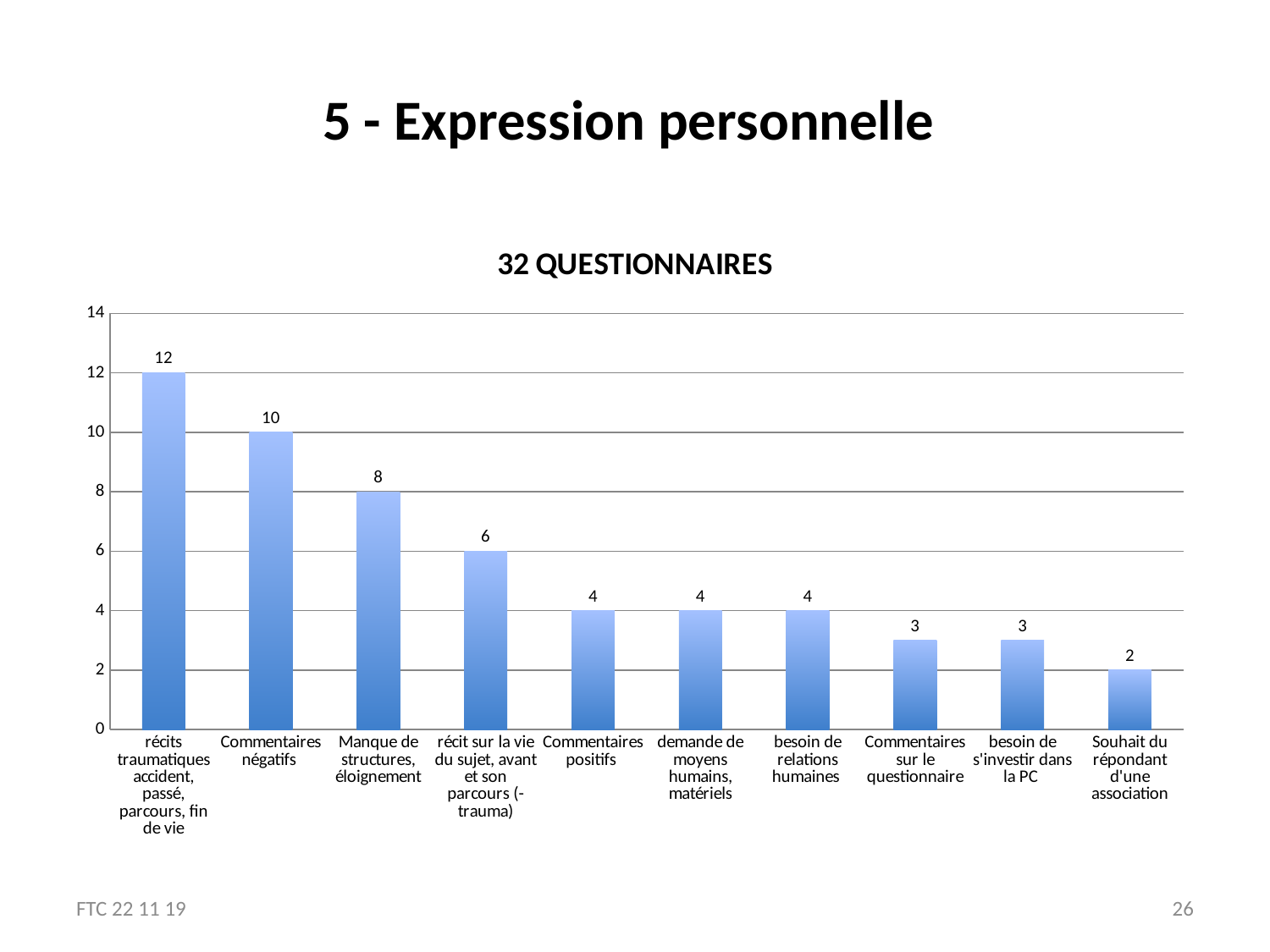
Which is larger, the value for "Commentaires positifs" or the value for "Commentaires sur le questionnaire"? Commentaires positifs How many categories are shown on the chart? 10 What is the value for "Manque de structures, éloignement"? 8 What is the value for "Souhait du répondant d'une association"? 2 What is the value for "Commentaires négatifs"? 10 Which category has the lowest value? Souhait du répondant d'une association What kind of chart is shown on the slide? bar chart What is the title of the chart? 32 QUESTIONNAIRES What is the difference between the values for "récits traumatiques accident, passé, parcours, fin de vie" and "Commentaires négatifs"? 2 Do the values rise or fall from left to right along the x axis? fall Which category has the highest value? récits traumatiques accident, passé, parcours, fin de vie Is the value for "récit sur la vie du sujet, avant et son parcours (-trauma)" greater or less than 4? greater